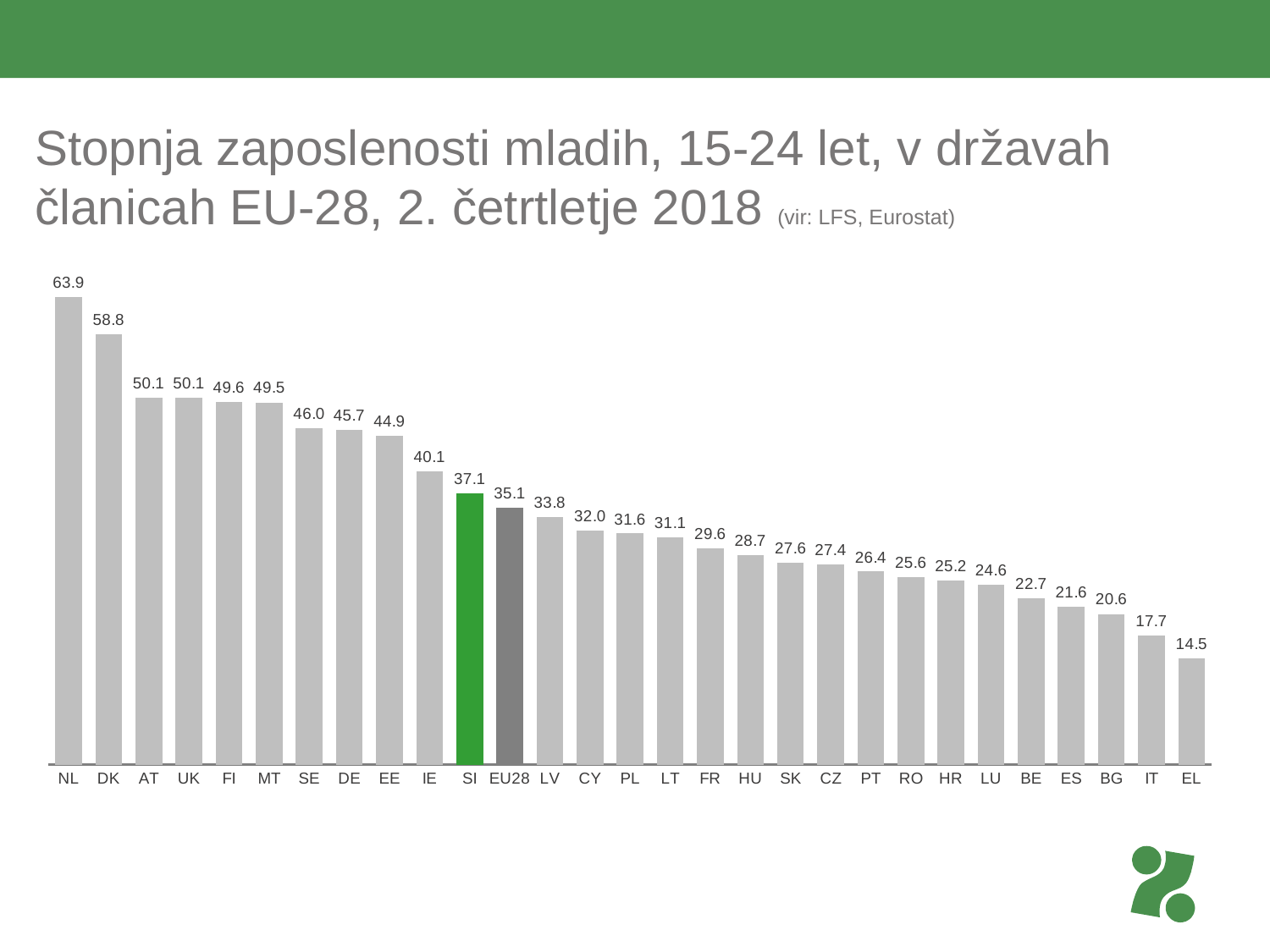
Which country has the lowest youth employment rate on the chart? EL Which country has the highest youth employment rate on the chart? NL Which has a higher value, IE or LV? IE What is the difference between the values for SI and EU28? 2.0 What is the value shown for NL? 63.9 What is the difference between the values for NL and DK? 5.1 How many bars are shown on the chart? 29 Which bar is coloured green on the chart? SI What is the value shown for IT? 17.7 What is the youth employment rate shown for SI? 37.1 What value is shown for EU28? 35.1 What kind of chart is shown on the slide? Bar chart